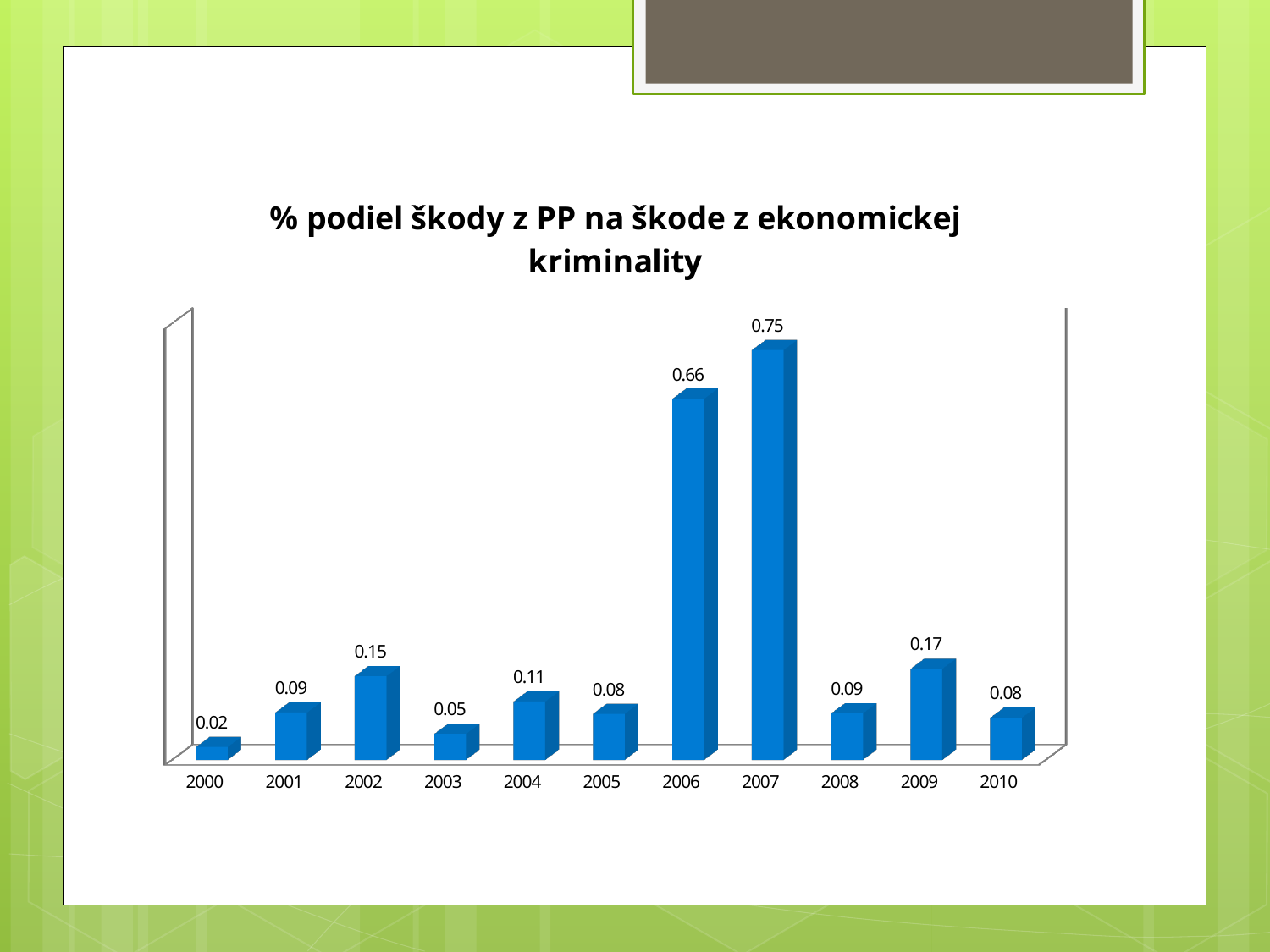
What is the difference between the values for 2002 and 2003? 0.10 What is the difference between the values for 2007 and 2006? 0.09 What is the title of the chart? % podiel škody z PP na škode z ekonomickej kriminality Which year has the highest value? 2007 Do the values rise or fall from 2007 to 2008? fall How many years are shown on the x axis? 11 Which year has the lowest value? 2000 What kind of chart is this? bar chart What is the value for 2009? 0.17 What is the value for 2000? 0.02 What is the value for 2007? 0.75 Which is larger, the value for 2004 or the value for 2005? 2004